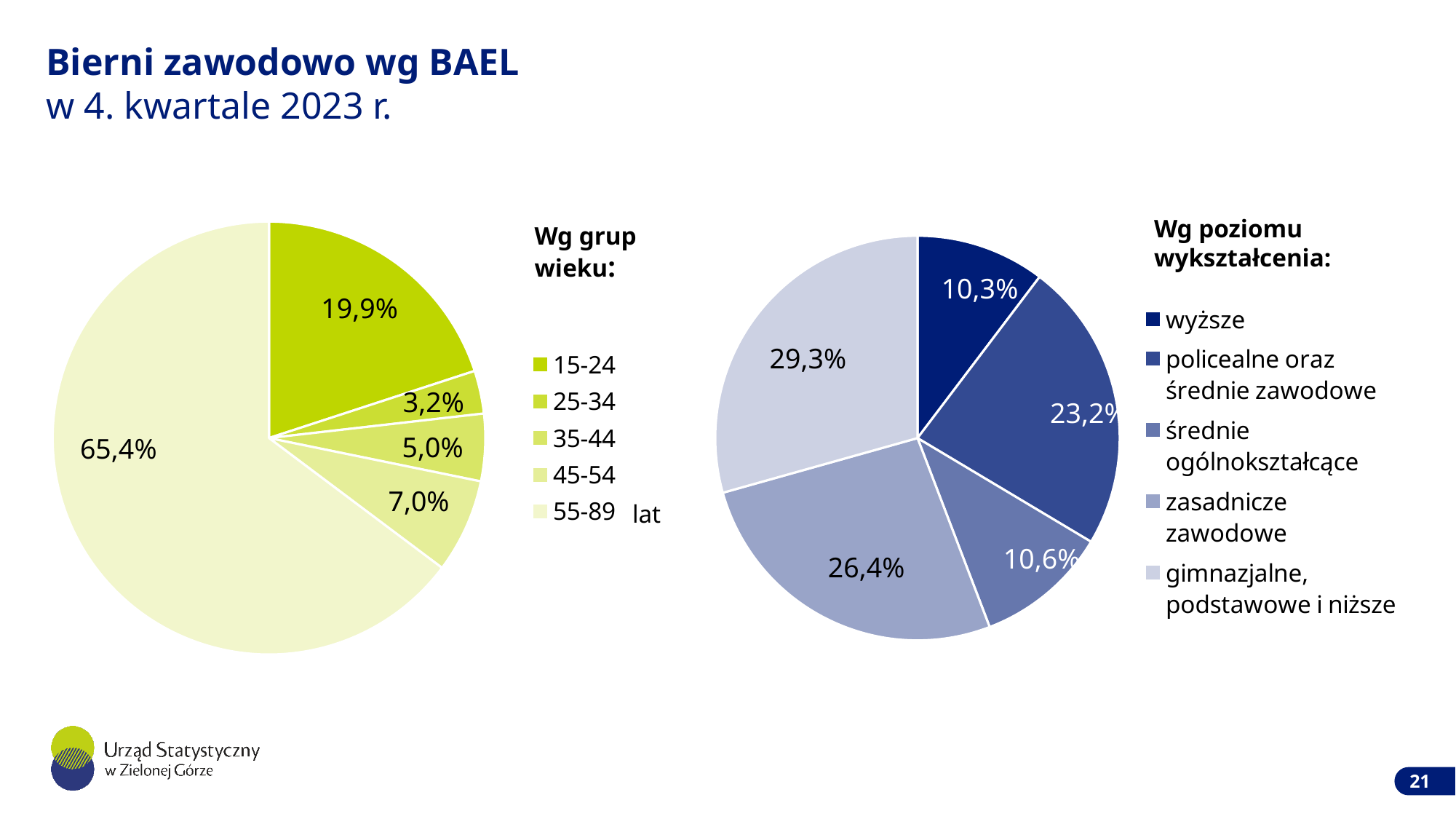
What type of chart is used for 'Wg poziomu wykształcenia'? pie chart In the 'Wg poziomu wykształcenia' pie chart, what share is shown for 'wyższe'? 10,3% In the 'Wg grup wieku' pie chart, how many age groups are shown? 5 In the 'Wg grup wieku' pie chart, what is the difference between the shares for 45-54 and 35-44? 2,0% In the 'Wg grup wieku' pie chart, which age group has the smallest share? 25-34 In the 'Wg grup wieku' pie chart, what share is shown for the 15-24 age group? 19,9% In the 'Wg poziomu wykształcenia' pie chart, which is larger: the share for 'policealne oraz średnie zawodowe' or for 'średnie ogólnokształcące'? policealne oraz średnie zawodowe In the 'Wg poziomu wykształcenia' pie chart, what is the difference between the shares for 'gimnazjalne, podstawowe i niższe' and 'zasadnicze zawodowe'? 2,9% How many entries does the legend of the 'Wg poziomu wykształcenia' chart list? 5 In the 'Wg poziomu wykształcenia' pie chart, what share is shown for 'zasadnicze zawodowe'? 26,4% In the 'Wg grup wieku' pie chart, what share is shown for the 55-89 age group? 65,4% In the 'Wg poziomu wykształcenia' pie chart, which education level has the largest share? gimnazjalne, podstawowe i niższe